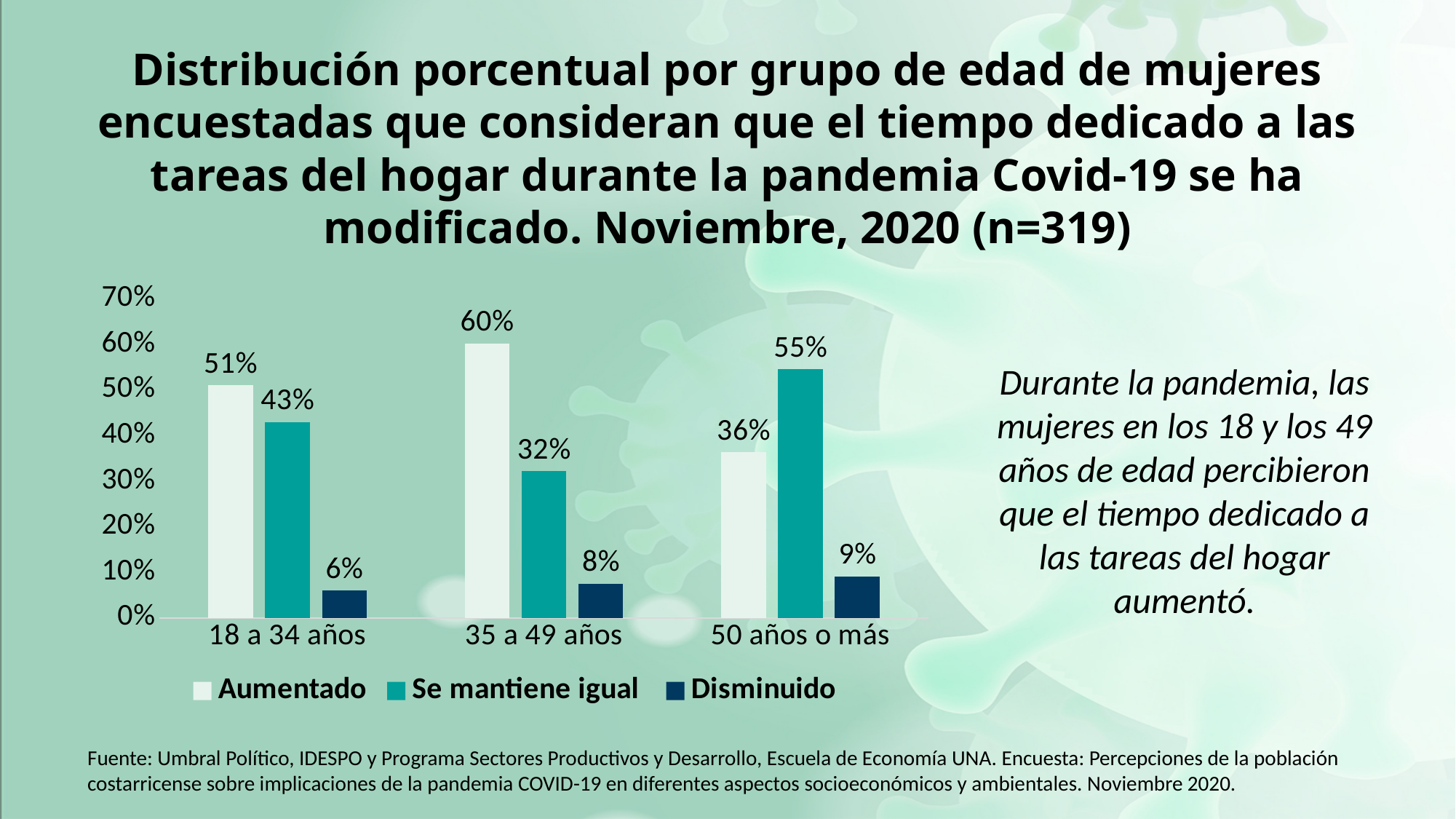
In the "50 años o más" group, which is larger: "Aumentado" or "Se mantiene igual"? Se mantiene igual What is the value for "Disminuido" in the "18 a 34 años" group? 6% How many series does the legend list? 3 Which age group has the highest value for "Aumentado"? 35 a 49 años Which age group has the lowest value for "Disminuido"? 18 a 34 años Is the value for "Se mantiene igual" in the "35 a 49 años" group greater or less than 40%? less What kind of chart is shown on the slide? bar chart How many age groups are shown on the x axis? 3 What are the three legend entries of the chart? Aumentado, Se mantiene igual, Disminuido What is the difference between "Aumentado" and "Se mantiene igual" in the "18 a 34 años" group? 8% What is the value for "Se mantiene igual" in the "50 años o más" group? 55% What is the value for "Aumentado" in the "35 a 49 años" group? 60%